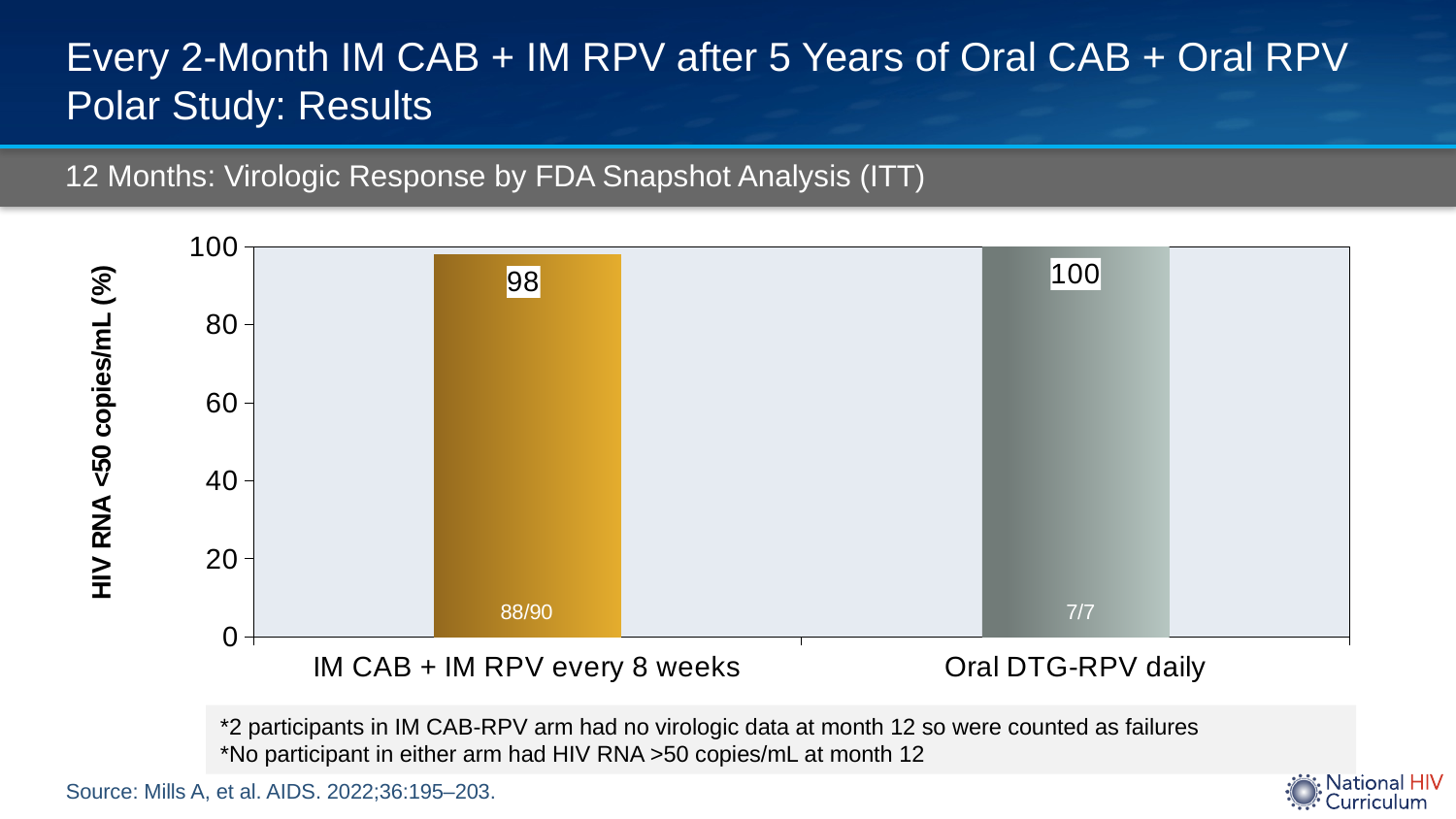
What kind of chart is shown on the slide? Bar chart What is the value for Oral DTG-RPV daily? 100 What fraction is printed at the bottom of the Oral DTG-RPV daily bar? 7/7 Which category has the lowest value? IM CAB + IM RPV every 8 weeks What is the value for IM CAB + IM RPV every 8 weeks? 98 What is the difference between the values for Oral DTG-RPV daily and IM CAB + IM RPV every 8 weeks? 2 What is the title of the chart? 12 Months: Virologic Response by FDA Snapshot Analysis (ITT) What fraction is printed at the bottom of the IM CAB + IM RPV every 8 weeks bar? 88/90 Which category has the highest value? Oral DTG-RPV daily Is the value for IM CAB + IM RPV every 8 weeks greater or less than 80? greater What is the label of the y axis? HIV RNA <50 copies/mL (%) How many categories are shown on the x axis? 2